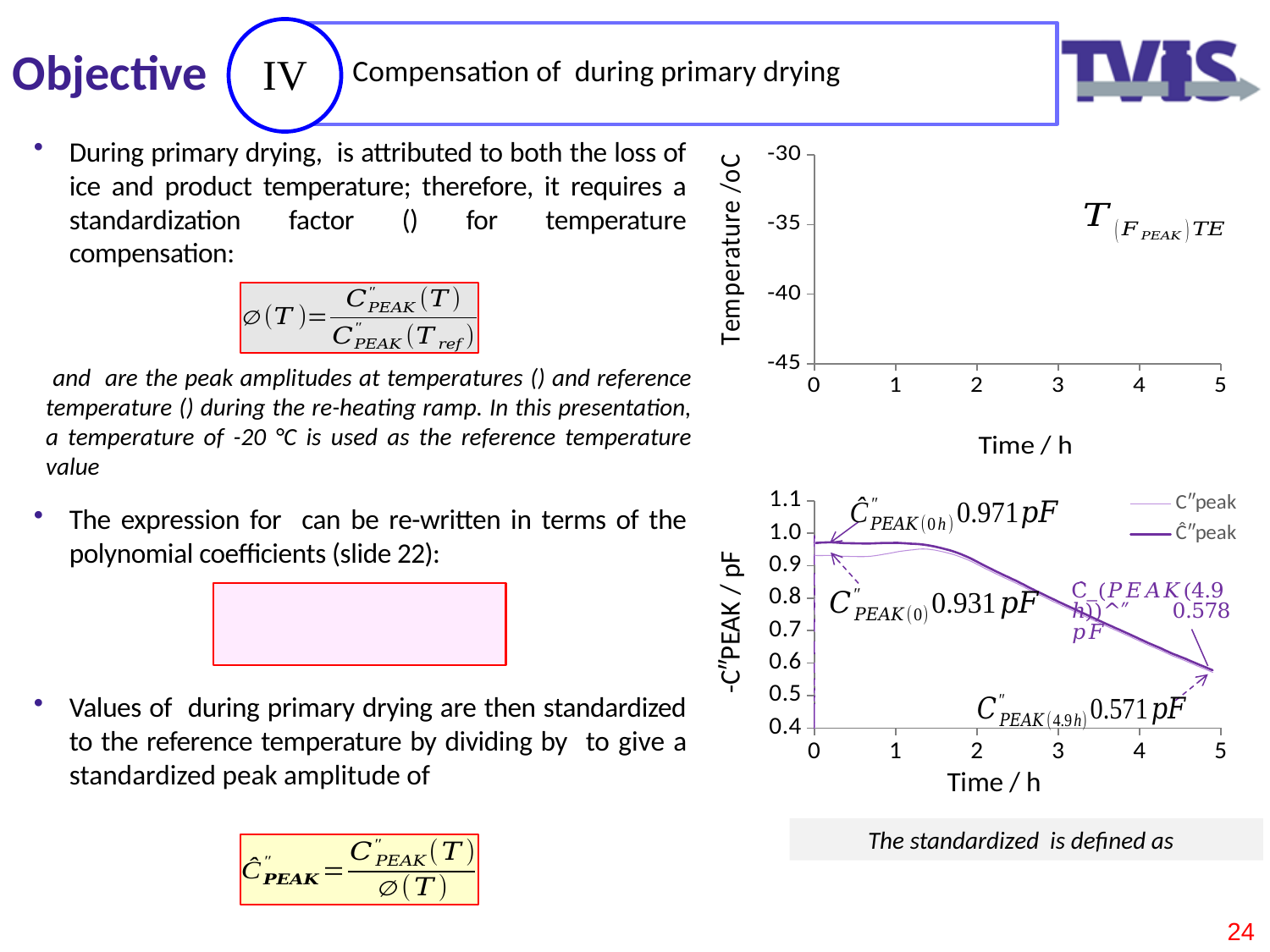
In the bottom chart (-C″PEAK / pF vs Time / h), by how much does the labelled Ĉ″peak value decrease from 0 h to 4.9 h? 0.393 pF In the bottom chart (-C″PEAK / pF vs Time / h), what is the labelled value of Ĉ″peak at 4.9 h? 0.578 pF In the bottom chart (-C″PEAK / pF vs Time / h), what is the labelled value of C″peak at 0 h? 0.931 pF What kind of chart is the bottom chart (-C″PEAK / pF vs Time / h)? line chart How many series does the legend of the bottom chart (-C″PEAK / pF vs Time / h) list? 2 In the bottom chart (-C″PEAK / pF vs Time / h), do the plotted values rise or fall as time increases from 2 h to 5 h? fall In the bottom chart (-C″PEAK / pF vs Time / h), what is the labelled value of C″peak at 4.9 h? 0.571 pF What is the y-axis label of the top chart on the slide? Temperature /oC In the bottom chart (-C″PEAK / pF vs Time / h), by how much does the labelled C″peak value decrease from 0 h to 4.9 h? 0.360 pF What is the x-axis label of the bottom chart on the slide? Time / h In the bottom chart (-C″PEAK / pF vs Time / h), which labelled value at 0 h is larger, Ĉ″peak or C″peak? Ĉ″peak In the bottom chart (-C″PEAK / pF vs Time / h), what is the labelled value of Ĉ″peak at 0 h? 0.971 pF